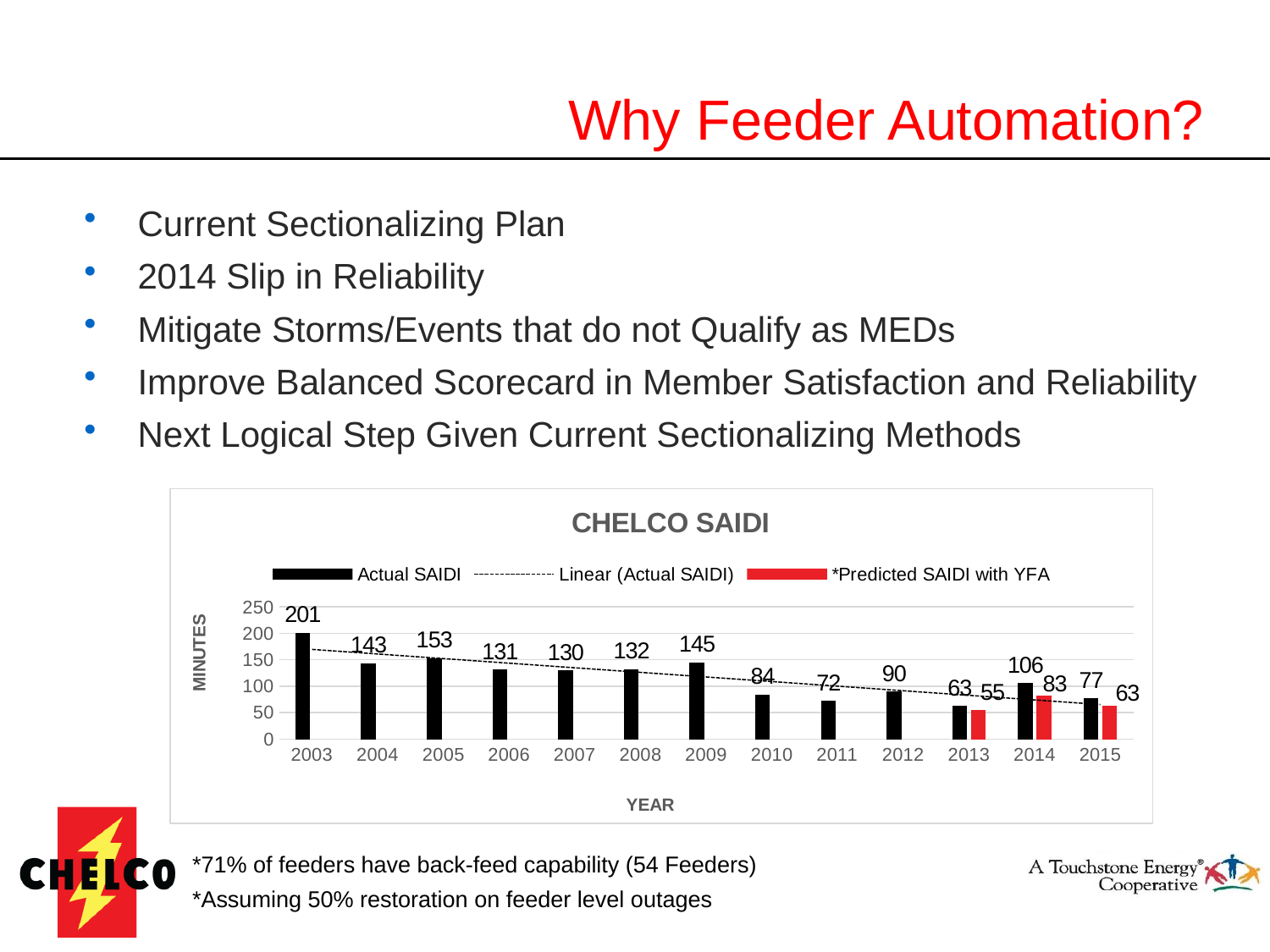
Which year has the lowest Actual SAIDI? 2013 Which year has the highest Actual SAIDI? 2003 How many entries does the legend list? 3 Which is larger, the Actual SAIDI for 2005 or for 2009? 2005 What is the Predicted SAIDI with YFA value for 2014? 83 What is the difference between the Actual SAIDI and the Predicted SAIDI with YFA in 2014? 23 Does the Actual SAIDI generally rise or fall from 2003 to 2015? fall What kind of chart is the CHELCO SAIDI chart? bar chart What is the Actual SAIDI value for 2011? 72 Is the Actual SAIDI value for 2010 greater or less than 100? less What is the Actual SAIDI value for 2003? 201 How many years are shown on the x axis? 13